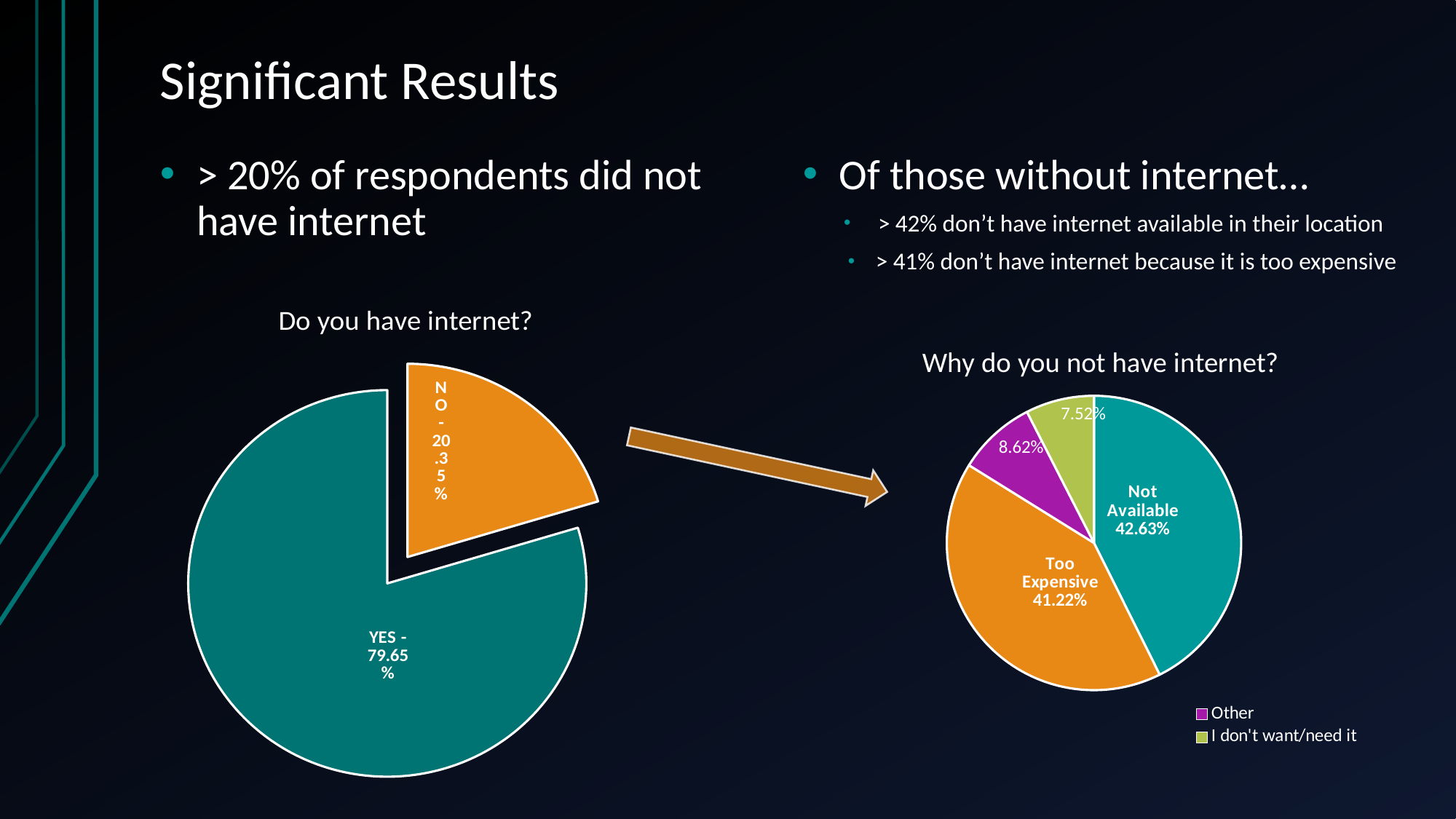
What kind of chart is "Do you have internet?"? Pie chart In the "Do you have internet?" chart, which slice is larger, YES or NO? YES In the "Why do you not have internet?" chart, what colour is the Too Expensive slice? Orange In the "Why do you not have internet?" chart, what is the difference between the Not Available and Too Expensive shares? 1.41% In the "Do you have internet?" chart, what share of respondents answered NO? 20.35% In the "Why do you not have internet?" chart, what share is labelled Not Available? 42.63% In the "Why do you not have internet?" chart, which category has the largest share? Not Available In the "Why do you not have internet?" chart, what share is labelled Too Expensive? 41.22% In the "Do you have internet?" chart, what share of respondents answered YES? 79.65% In the "Why do you not have internet?" chart, how many slices does the pie have? 4 In the "Why do you not have internet?" chart, which two categories are listed in the legend? Other and I don't want/need it In the "Do you have internet?" chart, what is the difference between the YES and NO shares? 59.30%